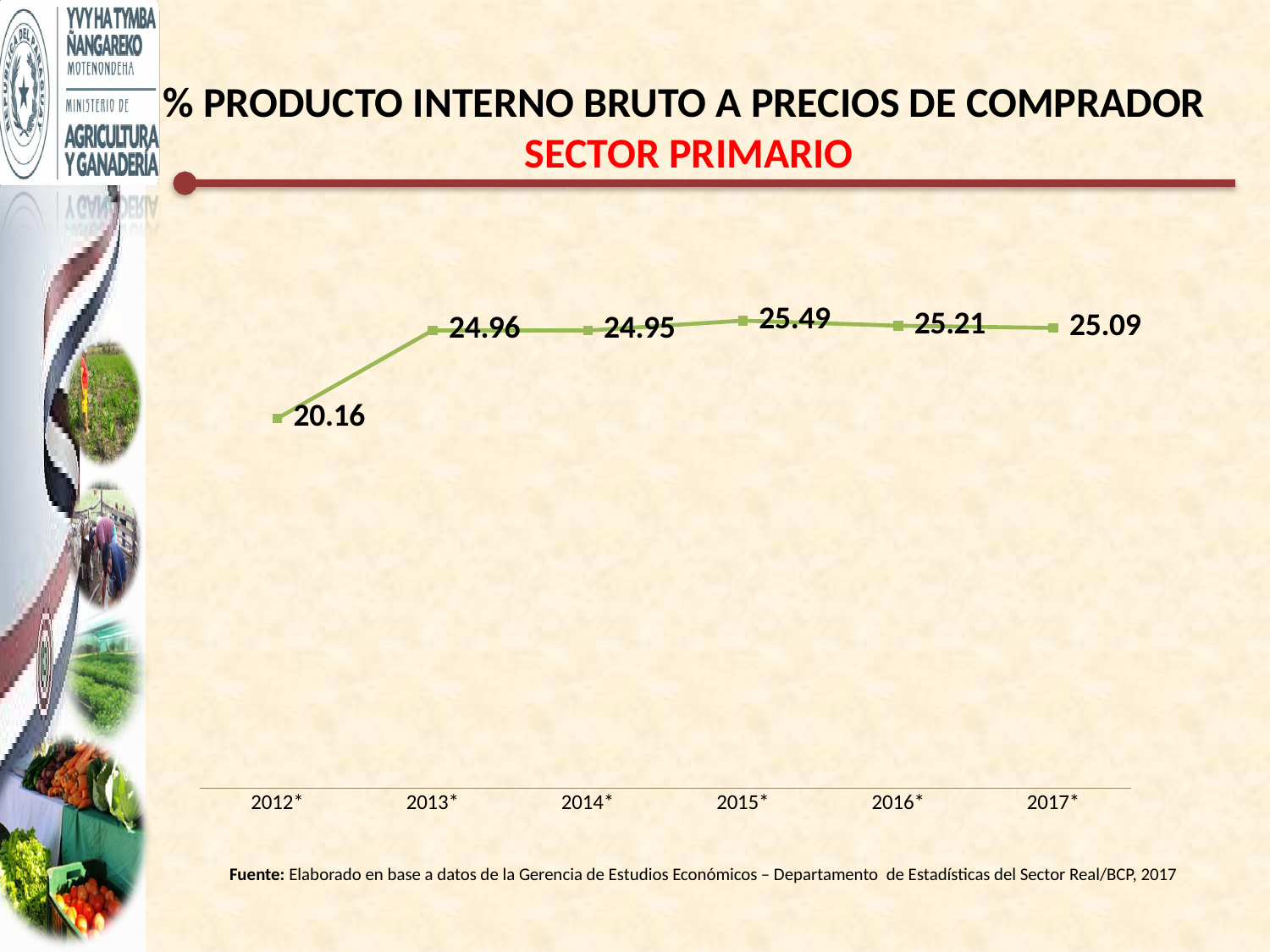
What is the value for 2017* on the chart? 25.09 Which is larger, the value for 2016* or the value for 2012*? 2016* What is the value for 2012* on the chart? 20.16 Does the value rise or fall from 2012* to 2013*? Rise How many years are plotted on the chart? 6 What is the value for 2015* on the chart? 25.49 Which year has the lowest value on the chart? 2012* What is the difference between the values for 2015* and 2017*? 0.40 Which year has the highest value on the chart? 2015* What kind of chart is shown on the slide? Line chart What is the value for 2016* on the chart? 25.21 What is the difference between the values for 2013* and 2012*? 4.80